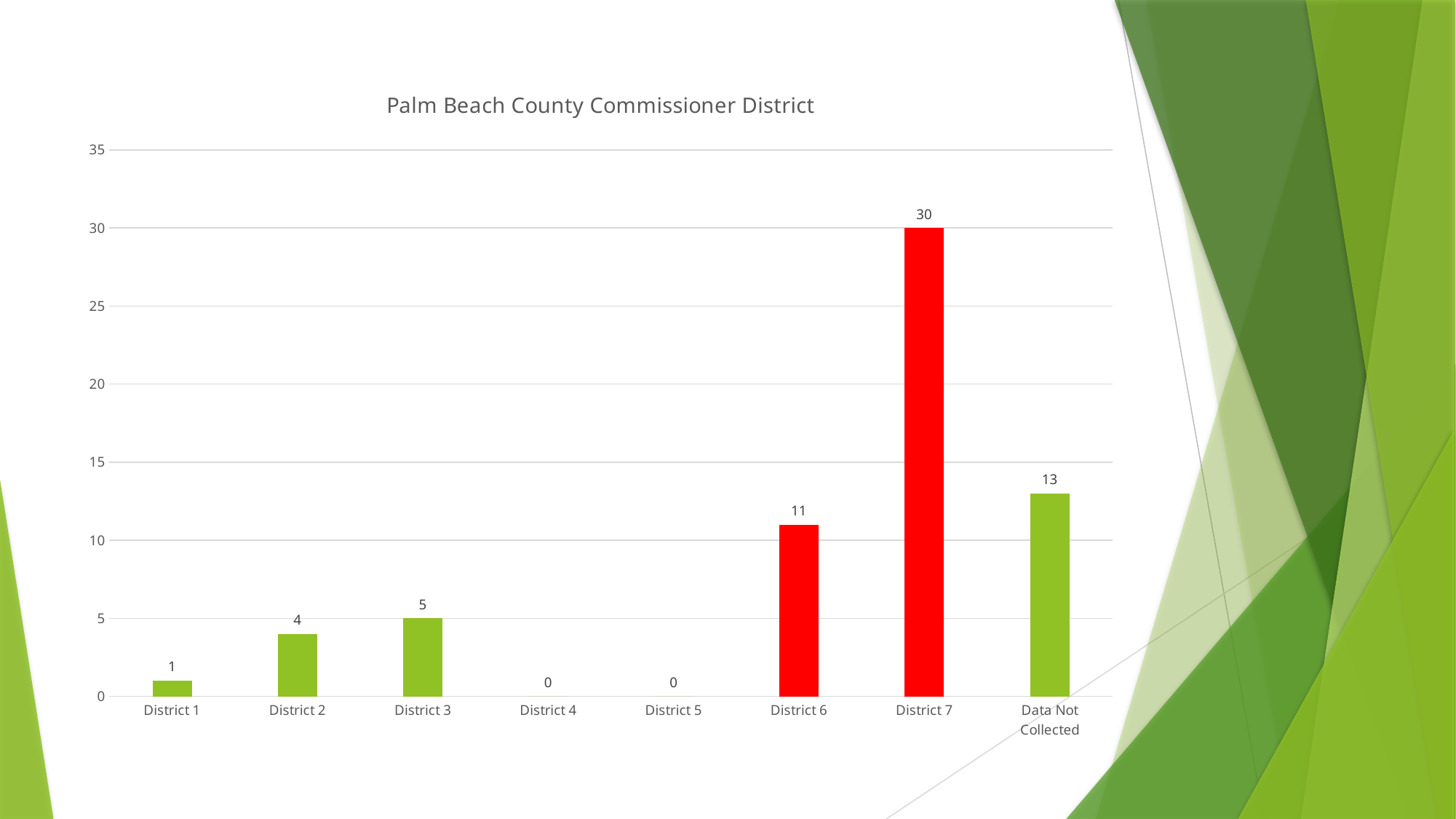
Is the value for District 6 greater or less than 10? greater How many categories are shown on the x axis? 8 What is the value for Data Not Collected? 13 What is the value for District 3? 5 What is the difference between the values for District 7 and District 6? 19 Which bars are coloured red? District 6 and District 7 What is the title of the chart? Palm Beach County Commissioner District Which category has the highest value? District 7 Which categories have a value of 0? District 4 and District 5 What kind of chart is shown on the slide? bar chart Which is larger, the value for District 2 or the value for District 3? District 3 What is the value for District 7? 30